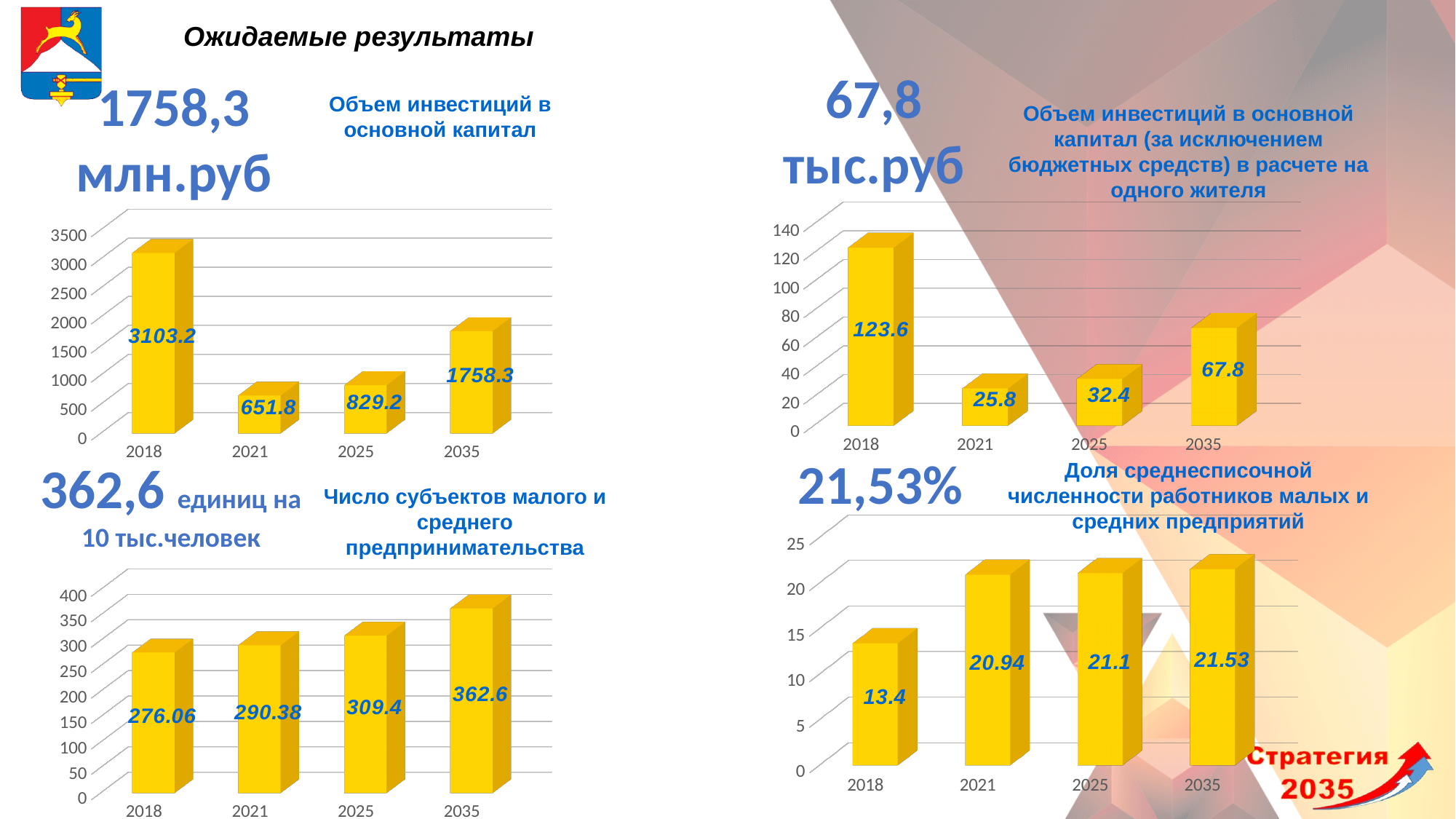
In the bottom-right chart (Доля среднесписочной численности работников малых и средних предприятий), what is the value for 2018? 13.4 In the bottom-left chart (Число субъектов малого и среднего предпринимательства), do the values rise or fall from 2018 to 2035? Rise In the bottom-right chart (Доля среднесписочной численности работников малых и средних предприятий), what is the difference between the 2035 and 2018 values? 8.13 In the top-left chart (Объем инвестиций в основной капитал), what is the value for 2018? 3103.2 What type of chart is the bottom-right chart (Доля среднесписочной численности работников малых и средних предприятий)? Bar chart In the bottom-left chart (Число субъектов малого и среднего предпринимательства), how many years are shown on the x axis? 4 In the top-right chart (Объем инвестиций в основной капитал ... на одного жителя), is the value for 2025 larger than the value for 2021? Yes In the top-left chart (Объем инвестиций в основной капитал), what is the difference between the 2035 and 2025 values? 929.1 In the bottom-left chart (Число субъектов малого и среднего предпринимательства), what is the value for 2021? 290.38 In the top-left chart (Объем инвестиций в основной капитал), which year has the lowest value? 2021 In the top-right chart (Объем инвестиций в основной капитал ... на одного жителя), which year has the highest value? 2018 In the top-right chart (Объем инвестиций в основной капитал ... на одного жителя), what is the value for 2035? 67.8